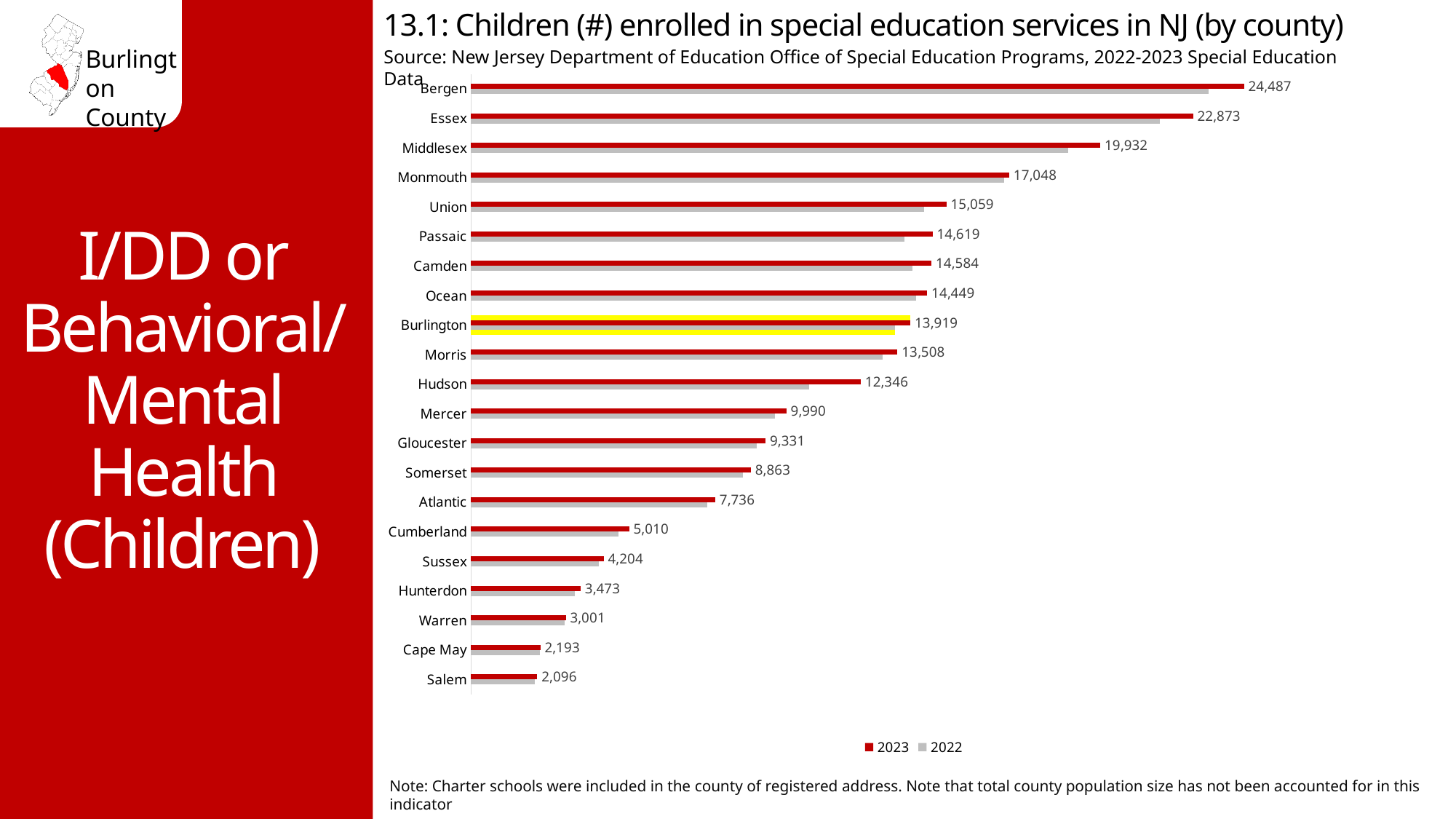
Which county has the lowest 2023 value? Salem Which is larger for Hudson County, the 2023 value or the 2022 value? 2023 What type of chart is shown on the slide? bar chart What is the difference between the 2023 values for Bergen and Essex? 1,614 Which year does the red bar represent according to the legend? 2023 Which county has the highest 2023 value? Bergen What is the 2023 value for Cumberland County? 5,010 What is the 2023 number of children enrolled in special education services in Burlington County? 13,919 How many series does the legend list? 2 What is the 2023 value for Middlesex County? 19,932 How many counties are listed on the chart? 21 What is the difference between the 2023 values for Burlington and Morris? 411